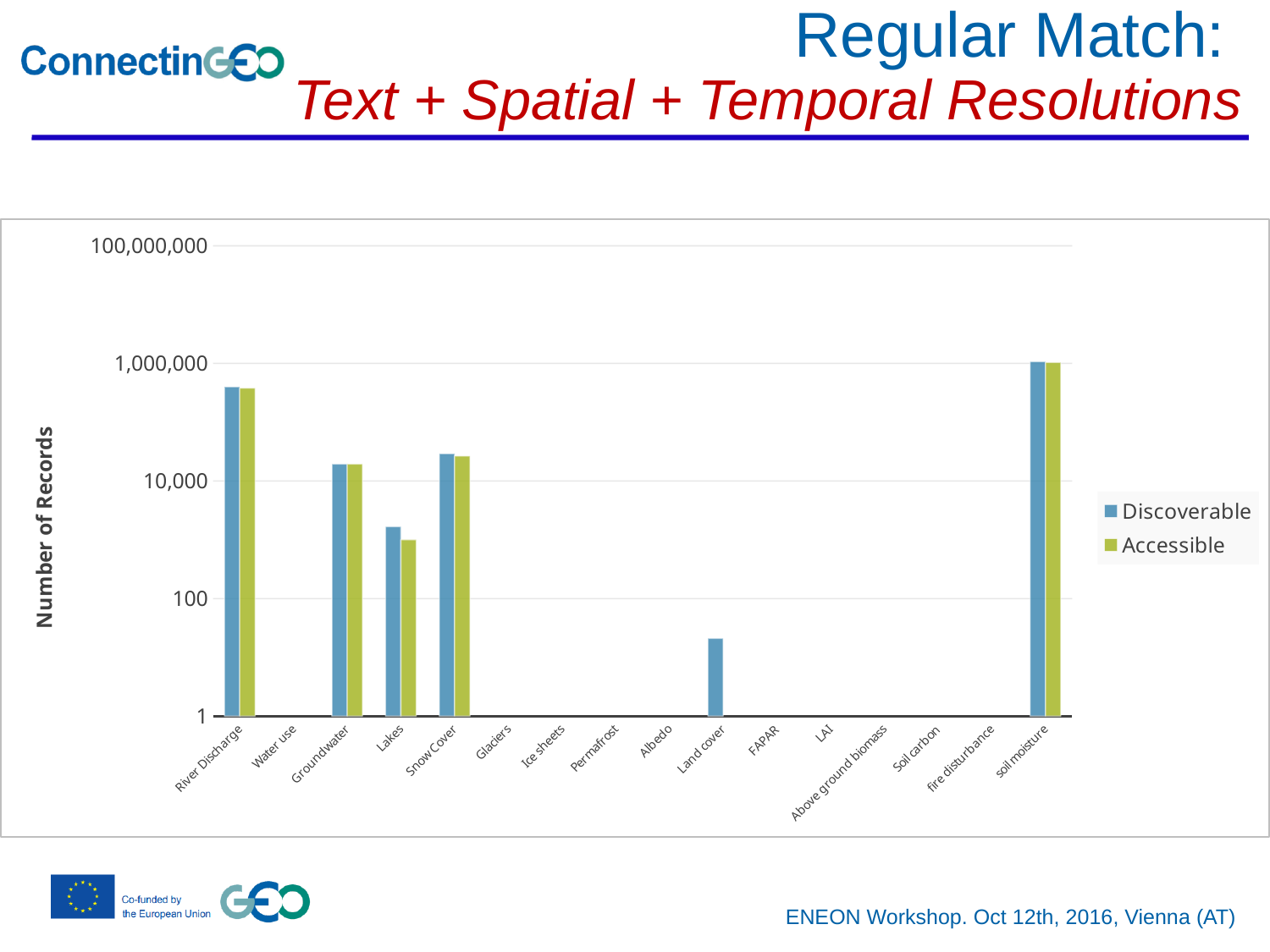
Is the Discoverable value for Land cover greater or less than 100? less Which category has a Discoverable bar but no Accessible bar? Land cover Is the Discoverable value for River Discharge greater or less than 10,000? greater How many series does the legend list? 2 What are the two series named in the legend? Discoverable and Accessible Is the Discoverable value for River Discharge greater or less than 1,000,000? less Which category has the highest number of records? soil moisture What kind of chart is shown on the slide? bar chart For Lakes, which is larger: the Discoverable value or the Accessible value? Discoverable How many categories are shown along the x axis? 16 Which has a larger Discoverable value: Snow Cover or Lakes? Snow Cover